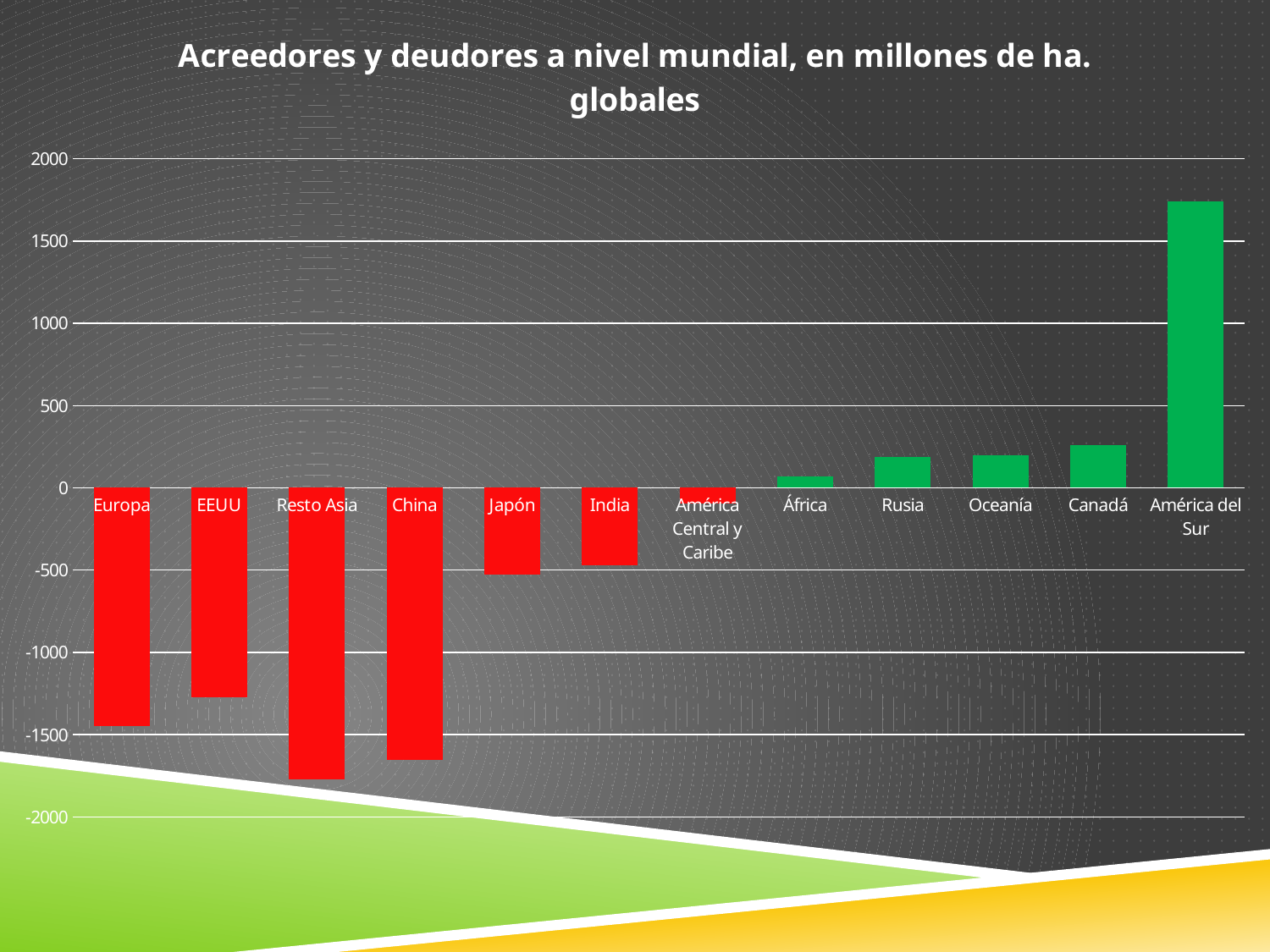
Which category has the lowest value? Resto Asia Which category has the highest value? América del Sur Is the value for India greater or less than -500? greater Which has the larger value, Canadá or Rusia? Canadá What is the title of the chart? Acreedores y deudores a nivel mundial, en millones de ha. globales Is the value for Europa greater or less than -1000? less How many categories are plotted on the x axis? 12 Is the value for América del Sur greater or less than 1500? greater Which has the larger value, EEUU or Europa? EEUU Do the values generally rise or fall moving from left to right along the x axis? rise What kind of chart is shown on the slide? Bar chart